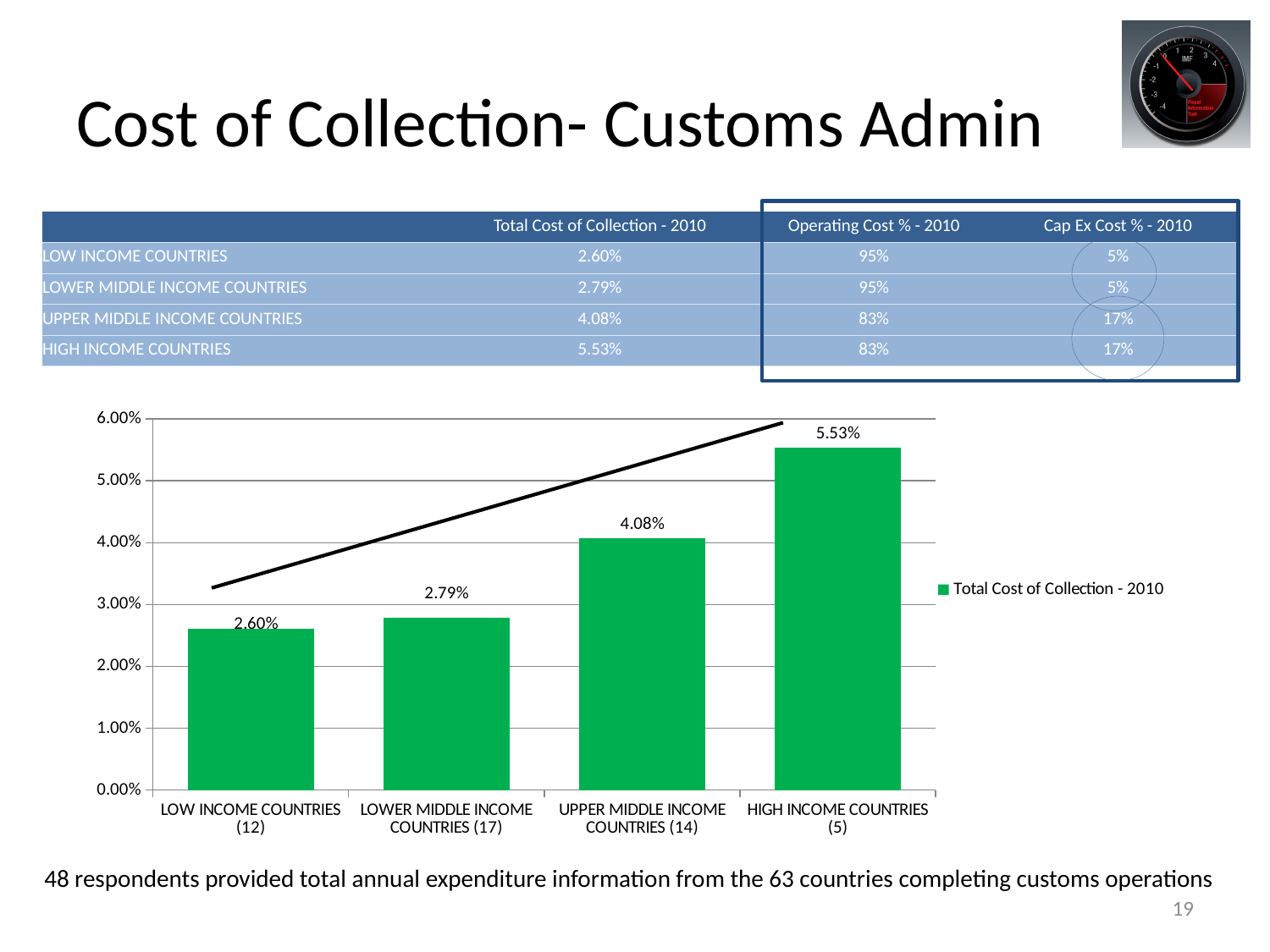
Do the values rise or fall from LOW INCOME COUNTRIES (12) to HIGH INCOME COUNTRIES (5)? rise What is the difference between the Total Cost of Collection - 2010 for HIGH INCOME COUNTRIES (5) and LOW INCOME COUNTRIES (12)? 2.93% What is the Total Cost of Collection - 2010 for LOW INCOME COUNTRIES (12)? 2.60% What is the Total Cost of Collection - 2010 for HIGH INCOME COUNTRIES (5)? 5.53% What kind of chart is shown on the slide? bar chart Which is larger, the Total Cost of Collection - 2010 for LOWER MIDDLE INCOME COUNTRIES (17) or for UPPER MIDDLE INCOME COUNTRIES (14)? UPPER MIDDLE INCOME COUNTRIES (14) How many categories are shown on the x axis of the chart? 4 Is the value for UPPER MIDDLE INCOME COUNTRIES (14) greater or less than 5.00%? less What is the Total Cost of Collection - 2010 for UPPER MIDDLE INCOME COUNTRIES (14)? 4.08% How many series does the chart legend list? 1 Which category has the highest Total Cost of Collection - 2010? HIGH INCOME COUNTRIES (5) Which category has the lowest Total Cost of Collection - 2010? LOW INCOME COUNTRIES (12)